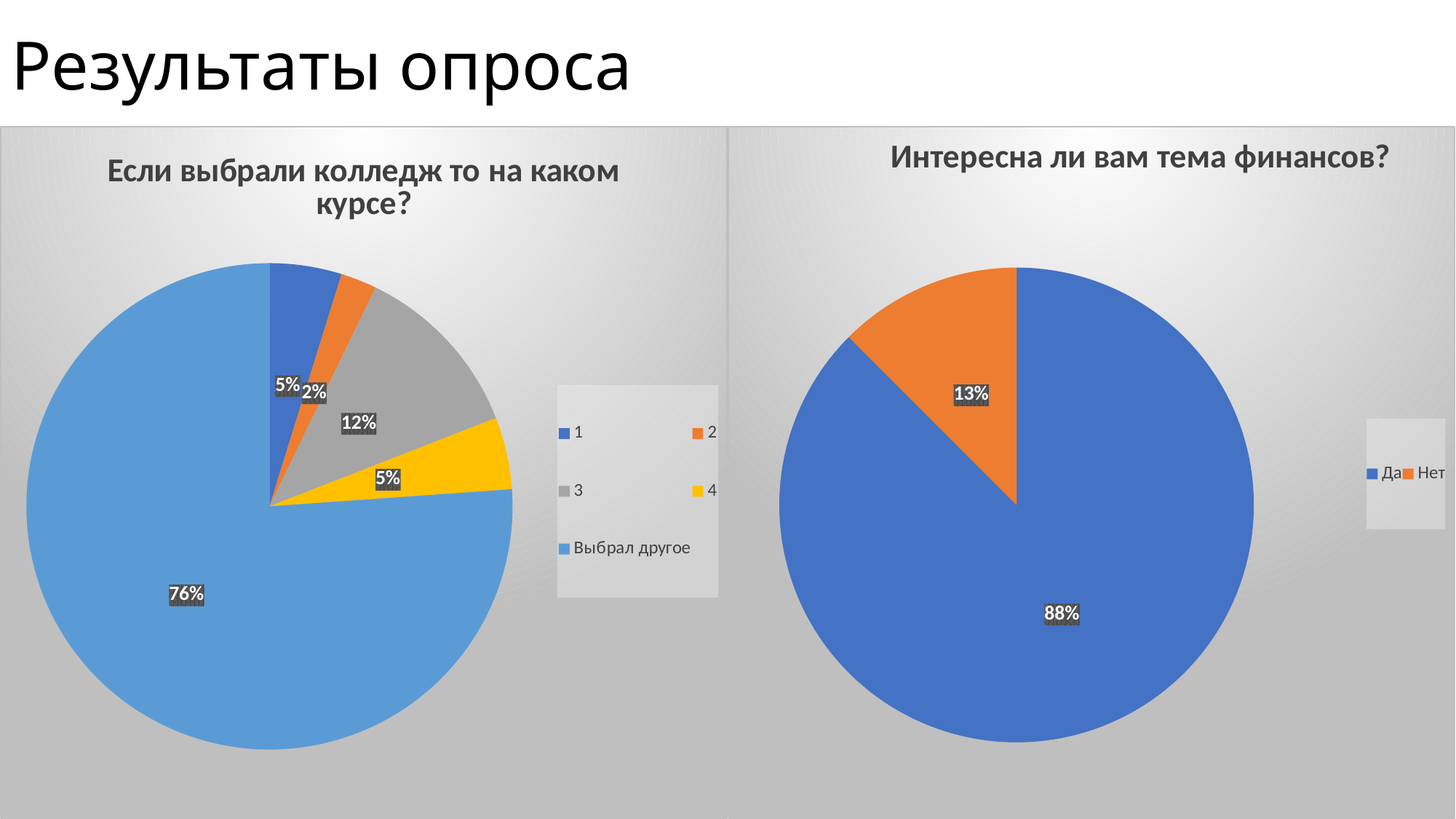
In the chart titled "Если выбрали колледж то на каком курсе?", what is the difference in percentage points between category 3 and category 1? 7 In the chart titled "Если выбрали колледж то на каком курсе?", what percentage is shown for category 2? 2% In the chart titled "Интересна ли вам тема финансов?", what percentage answered "Нет"? 13% In the chart titled "Если выбрали колледж то на каком курсе?", which category has the smallest slice? 2 In the chart titled "Интересна ли вам тема финансов?", how many entries does the legend list? 2 In the chart titled "Интересна ли вам тема финансов?", what percentage answered "Да"? 88% In the chart titled "Если выбрали колледж то на каком курсе?", what share of the pie is labelled "Выбрал другое"? 76% In the chart titled "Если выбрали колледж то на каком курсе?", how many slices does the pie have? 5 In the chart titled "Интересна ли вам тема финансов?", which answer is larger, "Да" or "Нет"? Да In the chart titled "Если выбрали колледж то на каком курсе?", which category has the largest slice? Выбрал другое What type of chart is used for "Интересна ли вам тема финансов?"? Pie chart In the chart titled "Если выбрали колледж то на каком курсе?", what percentage is shown for category 3? 12%